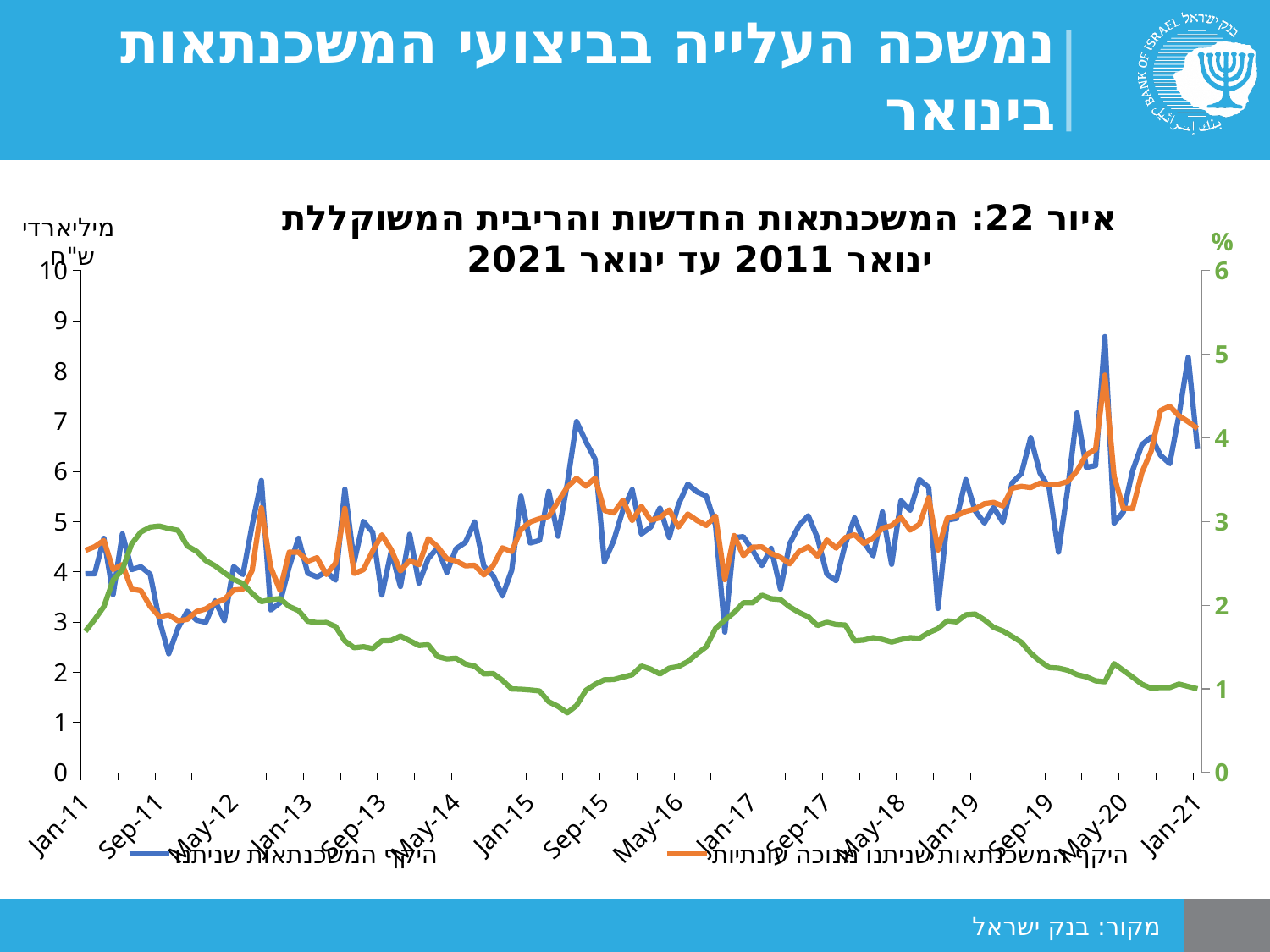
What is the maximum value shown on the left vertical axis? 10 Is the lowest point of the blue line (היקף המשכנתאות שניתנו), near the end of 2011, greater or less than 3 on the left axis? less Which line reaches the highest point on the chart, the blue, orange or green line? Blue What kind of chart is shown on the slide? Line chart How many lines are plotted on the chart? 3 What is the title of the chart? איור 22: המשכנתאות החדשות והריבית המשוקללת ינואר 2011 עד ינואר 2021 Does the green line rise or fall between Sep-11 and May-15? Falls What is the maximum value shown on the right vertical axis? 6 What unit is shown on the left vertical axis? מיליארדי ש"ח Is the peak of the blue line (היקף המשכנתאות שניתנו) around May-20 greater or less than 8 on the left axis? greater Is the value of the orange line (היקף המשכנתאות שניתנו מנוכה עונתיות) at Jan-21 greater or less than 6 on the left axis? greater Overall, does the blue line (היקף המשכנתאות שניתנו) rise or fall from Jan-11 to Jan-21? Rises